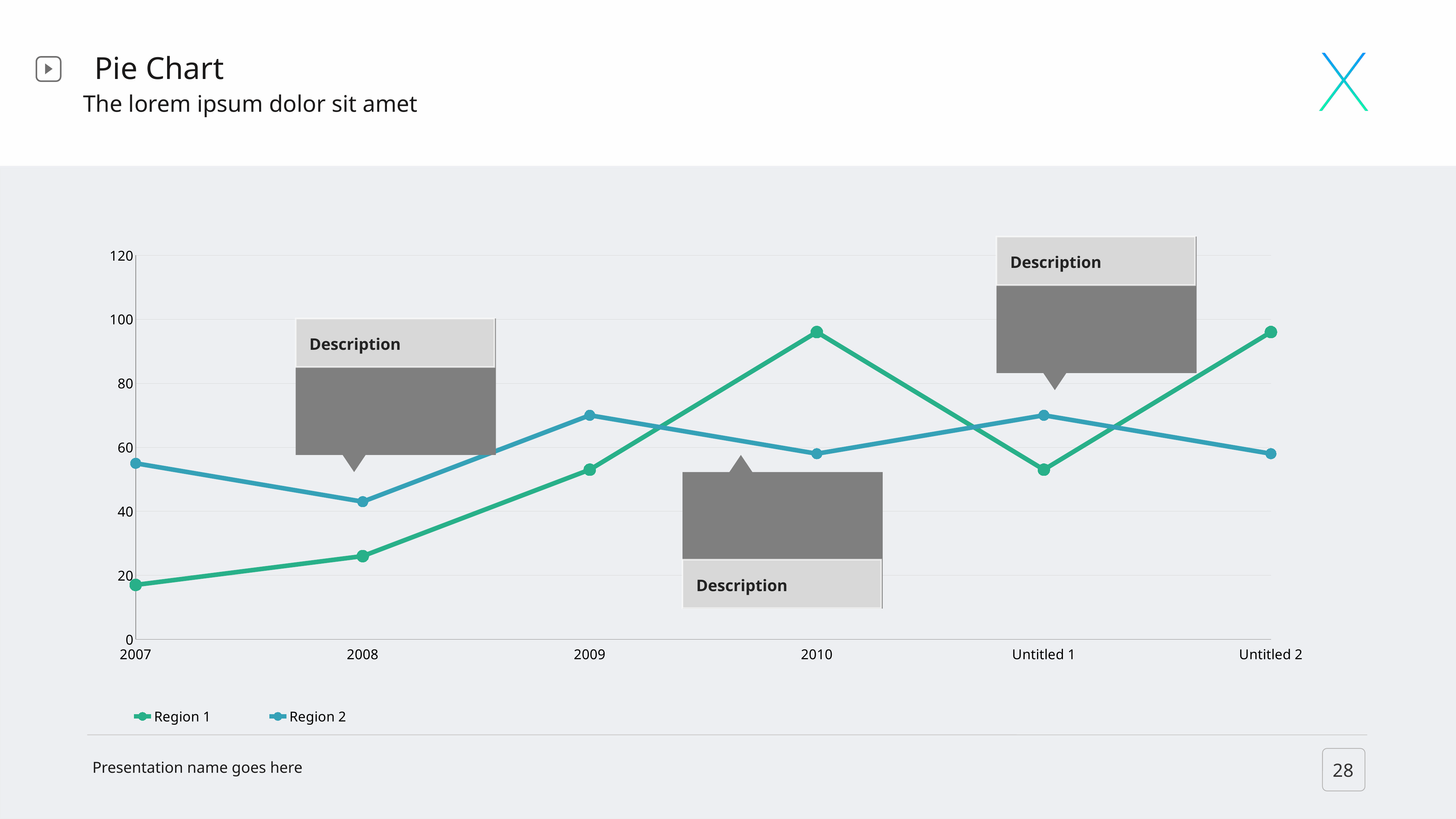
What kind of chart is shown on the slide? line chart Does the Region 1 line rise or fall from 2007 to 2010? rise In which category does Region 2 have its lowest value? 2008 Which series is plotted in green? Region 1 How many categories are shown along the x axis? 6 In 2010, which series has the larger value, Region 1 or Region 2? Region 1 In 2007, which series has the larger value, Region 1 or Region 2? Region 2 What is the title shown above the chart on the slide? Pie Chart How many series does the legend list? 2 Is the value for Region 2 in 2009 greater or less than 60? greater In which category does Region 1 have its lowest value? 2007 Is the value for Region 1 in 2010 greater or less than 80? greater